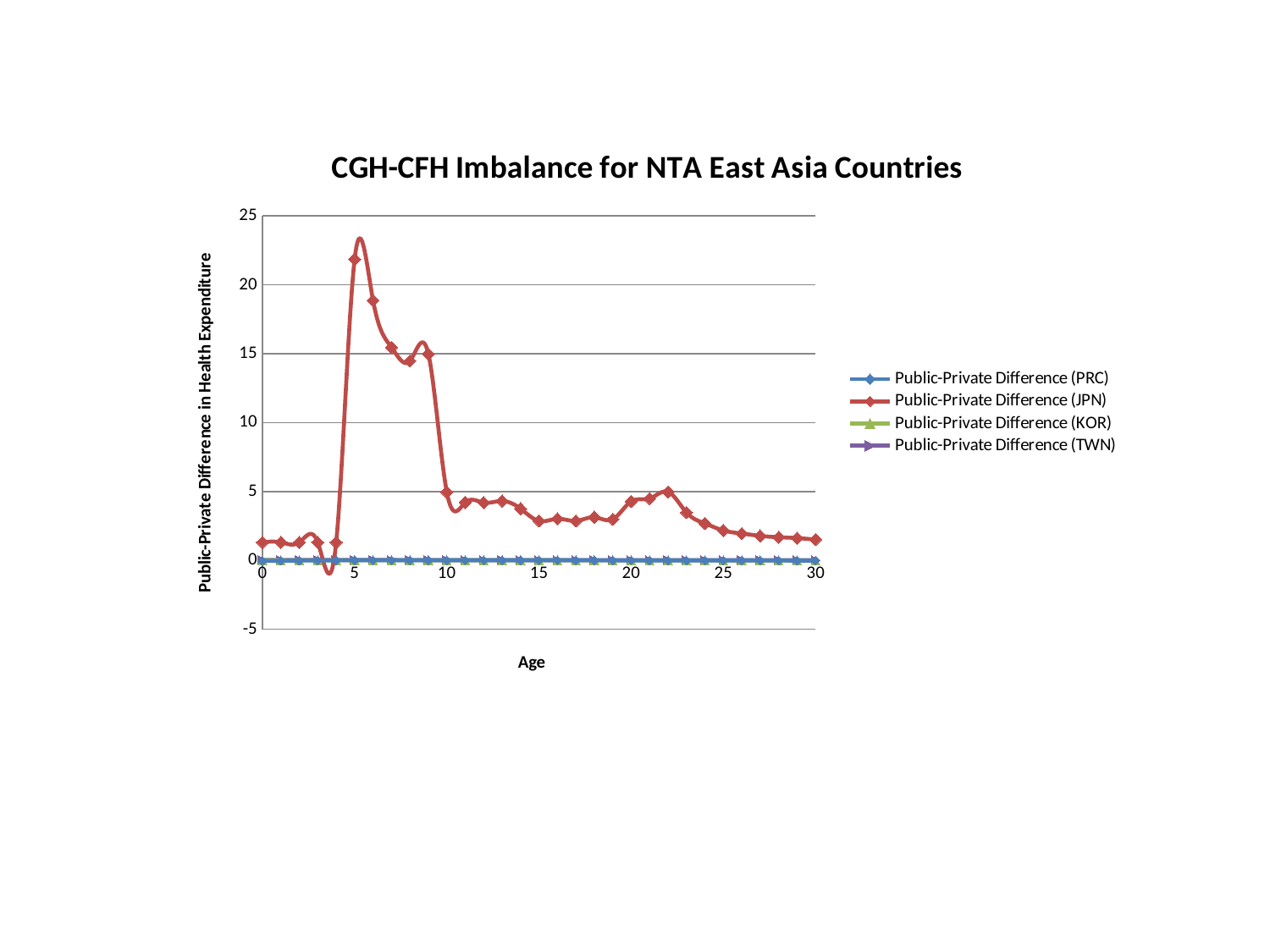
Is the value for Public-Private Difference (JPN) at age 15 greater or less than 5? less Which is larger at age 5: the value for Public-Private Difference (JPN) or the value for Public-Private Difference (PRC)? Public-Private Difference (JPN) Does the value for Public-Private Difference (JPN) rise or fall between age 22 and age 30? fall Is the value for Public-Private Difference (JPN) at age 5 greater or less than 20? greater Does the value for Public-Private Difference (JPN) rise or fall between age 4 and age 5? rise How many series does the legend list? 4 Which series reaches the highest value on the chart? Public-Private Difference (JPN) Is the value for Public-Private Difference (JPN) at age 30 greater or less than 5? less What kind of chart is shown on the slide? line chart What is the label of the x axis? Age What is the title of the chart? CGH-CFH Imbalance for NTA East Asia Countries